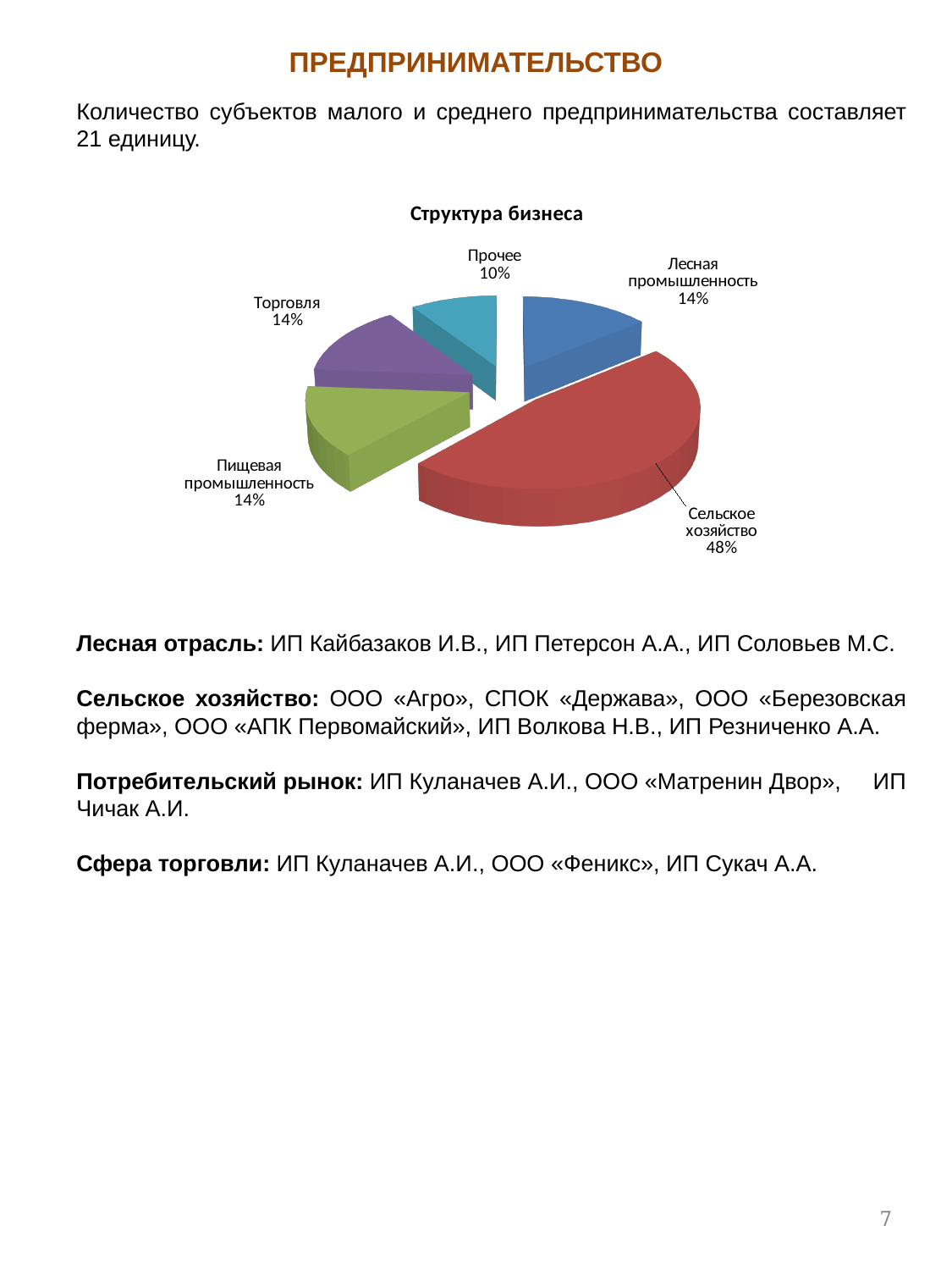
What share of the pie does "Лесная промышленность" have? 14% What kind of chart is shown under the title "Структура бизнеса"? Pie chart Which category has the smallest slice of the pie? Прочее Which category has the largest slice of the pie? Сельское хозяйство Which is larger, the share of "Торговля" or the share of "Прочее"? Торговля What colour is the "Сельское хозяйство" slice? Red How many slices does the pie chart have? 5 What share of the pie does "Торговля" have? 14% What share of the pie does "Сельское хозяйство" have? 48% What is the title of the chart? Структура бизнеса What is the difference in percentage points between "Сельское хозяйство" and "Пищевая промышленность"? 34